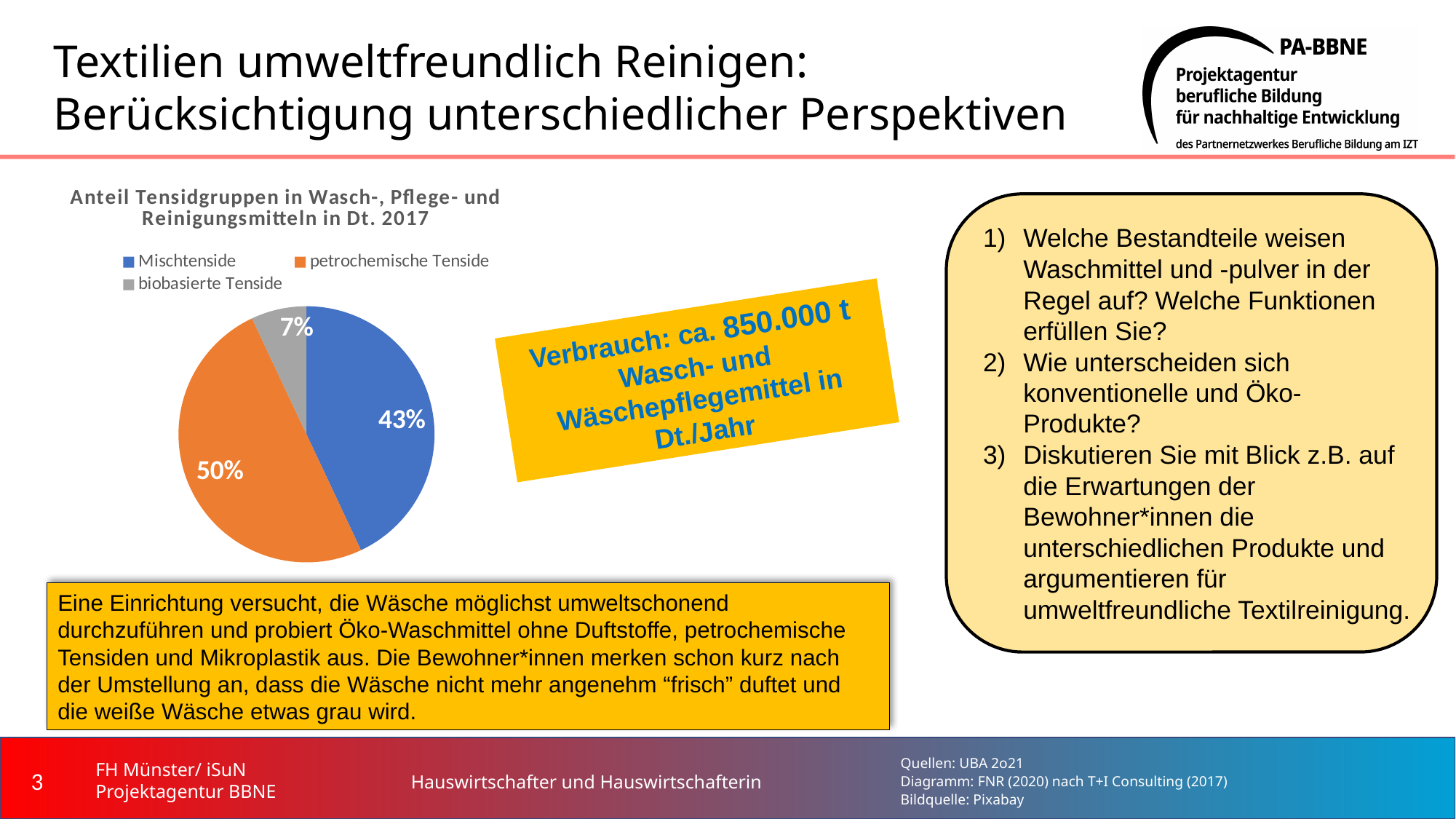
What is the title of the pie chart? Anteil Tensidgruppen in Wasch-, Pflege- und Reinigungsmitteln in Dt. 2017 What kind of chart is shown on the slide? pie chart Which has a larger share, Mischtenside or biobasierte Tenside? Mischtenside What is the share of Mischtenside in the pie chart? 43% How many entries does the legend of the pie chart list? 3 What is the share of biobasierte Tenside in the pie chart? 7% How many slices does the pie chart have? 3 What is the share of petrochemische Tenside in the pie chart? 50% What is the difference in percentage points between petrochemische Tenside and Mischtenside? 7 Which surfactant group has the largest share in the pie chart? petrochemische Tenside Which surfactant group has the smallest share in the pie chart? biobasierte Tenside What is the difference in percentage points between Mischtenside and biobasierte Tenside? 36